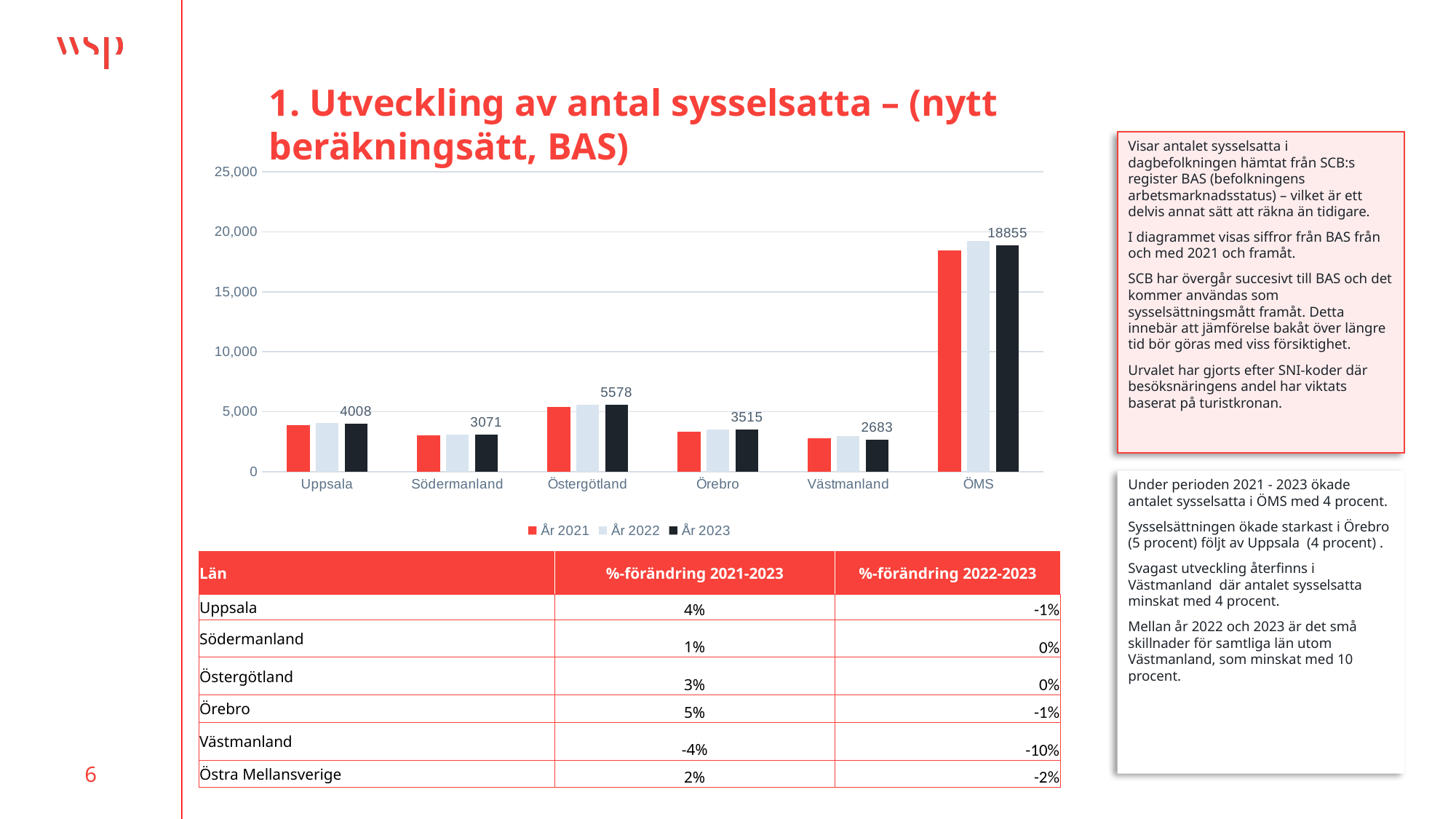
Which category has the highest value in the År 2023 series? ÖMS How many series does the chart legend list? 3 Which category has the lowest value in the År 2023 series? Västmanland What kind of chart is shown on the slide? Bar chart How many categories are shown on the x axis of the chart? 6 What is the value for Västmanland in the År 2023 series? 2683 What is the value for ÖMS in the År 2023 series? 18855 Is the value for ÖMS in the År 2021 series greater or less than 15,000? greater What is the difference between the År 2023 values for Östergötland and Örebro? 2063 What is the value for Uppsala in the År 2023 series? 4008 In the År 2023 series, which is larger: Uppsala or Södermanland? Uppsala What is the value for Östergötland in the År 2023 series? 5578